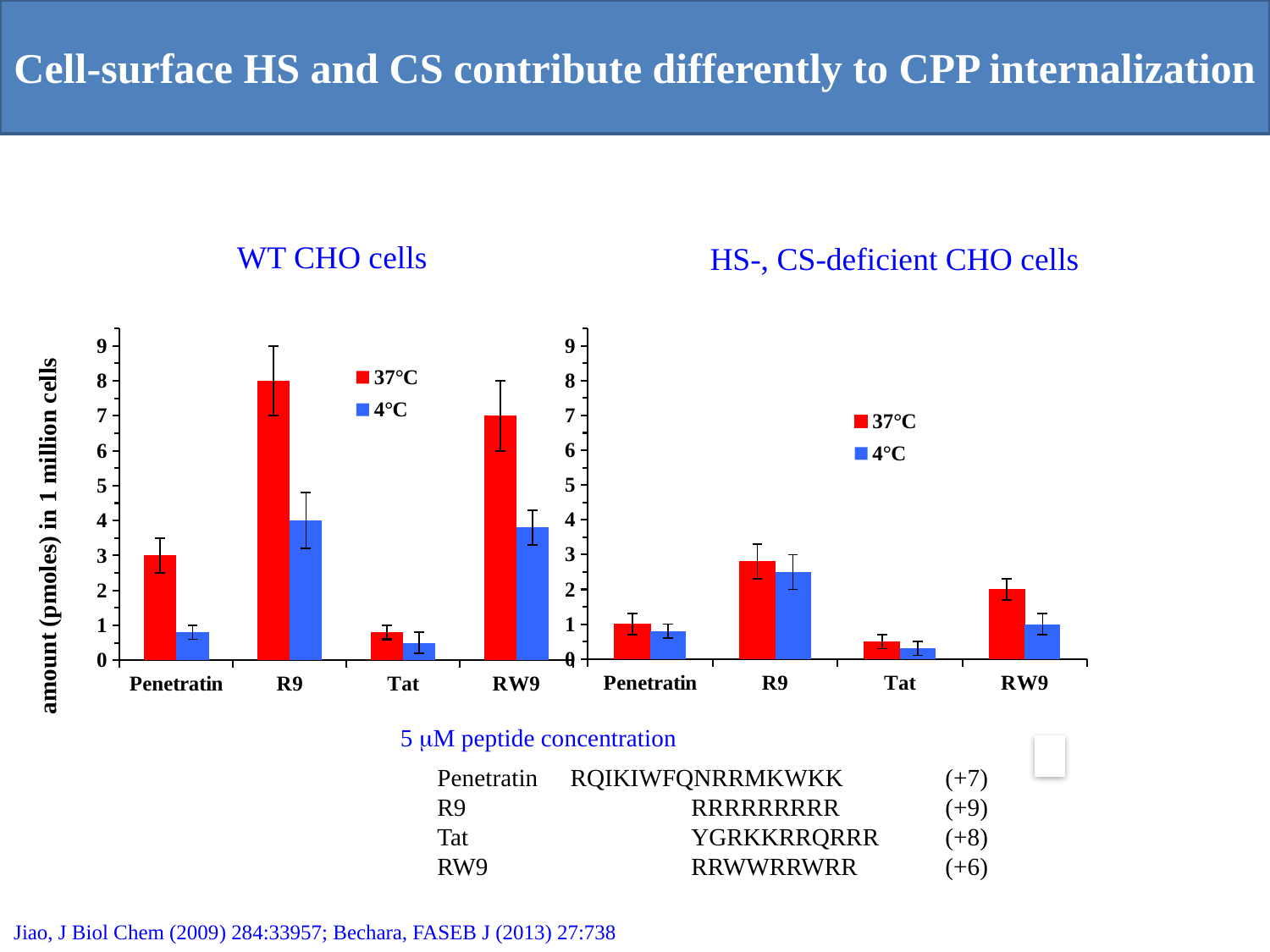
In the WT CHO cells chart, for R9, which is larger: the 37°C value or the 4°C value? 37°C In the WT CHO cells chart, what kind of chart is used? bar chart In the HS-, CS-deficient CHO cells chart, is the value for RW9 at 4°C greater or less than 2? less In the WT CHO cells chart, what are the two legend entries? 37°C and 4°C In the WT CHO cells chart, is the value for Penetratin at 4°C greater or less than 2? less In the WT CHO cells chart, which peptide has the highest value at 37°C? R9 In the WT CHO cells chart, which peptide has the lowest value at 37°C? Tat In the WT CHO cells chart, how many series does the legend list? 2 In the WT CHO cells chart, is the value for R9 at 37°C greater or less than 5? greater In the HS-, CS-deficient CHO cells chart, how many peptide categories are shown on the x axis? 4 In the HS-, CS-deficient CHO cells chart, which peptide has the highest value at 37°C? R9